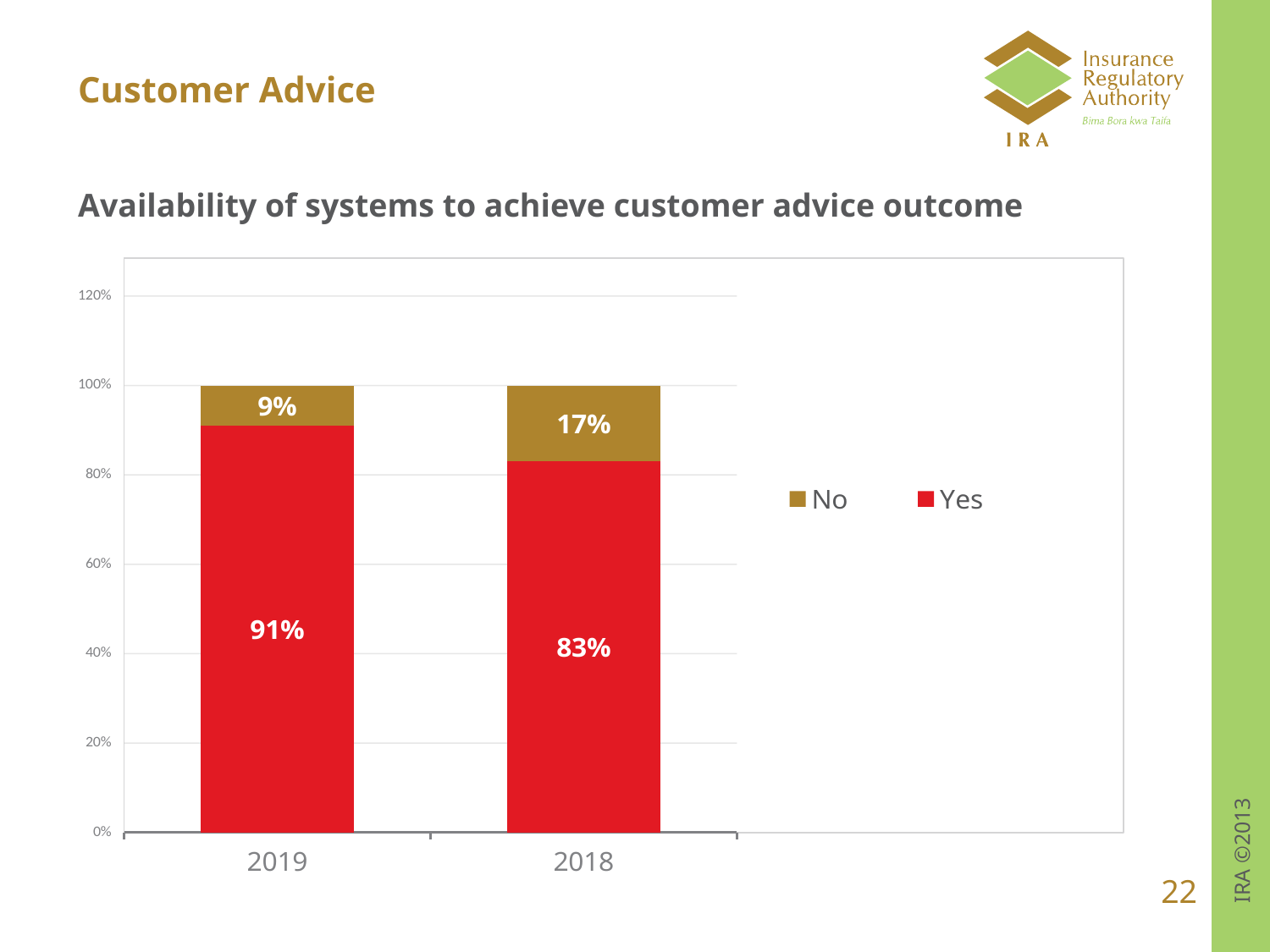
What is the total of the stacked bar for 2018? 100% Which year has the higher Yes percentage? 2019 What percentage of respondents answered No in 2019? 9% What is the difference between the Yes percentage in 2019 and in 2018? 8% What kind of chart is shown on the slide? Stacked bar chart What percentage of respondents answered Yes in 2019? 91% What percentage of respondents answered No in 2018? 17% Which year has the lower No percentage? 2019 Is the No percentage larger in 2018 or in 2019? 2018 What percentage of respondents answered Yes in 2018? 83% How many series does the legend list? 2 How many years are shown on the x axis? 2